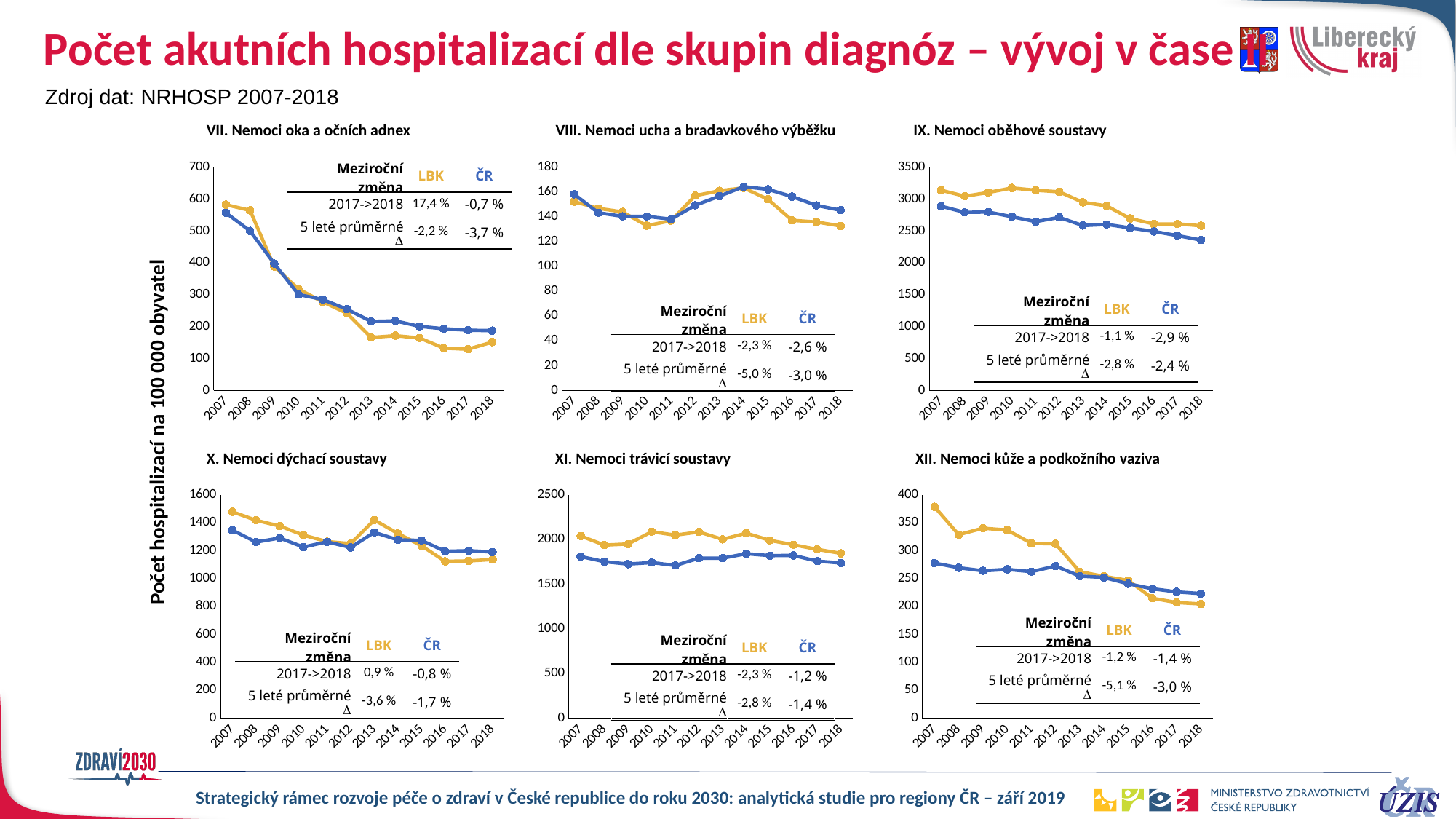
In the table on 'VII. Nemoci oka a očních adnex', what is the 2017->2018 change for LBK? 17,4 % In 'XI. Nemoci trávicí soustavy', is the ČR value for 2007 greater or less than 2000? less In 'VII. Nemoci oka a očních adnex', do the values for LBK rise or fall from 2007 to 2018? fall How many years are plotted on the x axis of 'IX. Nemoci oběhové soustavy'? 12 In 'VII. Nemoci oka a očních adnex', is the LBK value for 2007 greater or less than 500? greater How many series does each chart on the slide show? 2 What kind of chart is used for 'VII. Nemoci oka a očních adnex'? line chart In 'XII. Nemoci kůže a podkožního vaziva', which series has the higher value in 2007, LBK or ČR? LBK In 'X. Nemoci dýchací soustavy', is the LBK value for 2007 greater or less than 1400? greater In the table on 'XII. Nemoci kůže a podkožního vaziva', what is the '5 leté průměrné Δ' value for LBK? -5,1 %